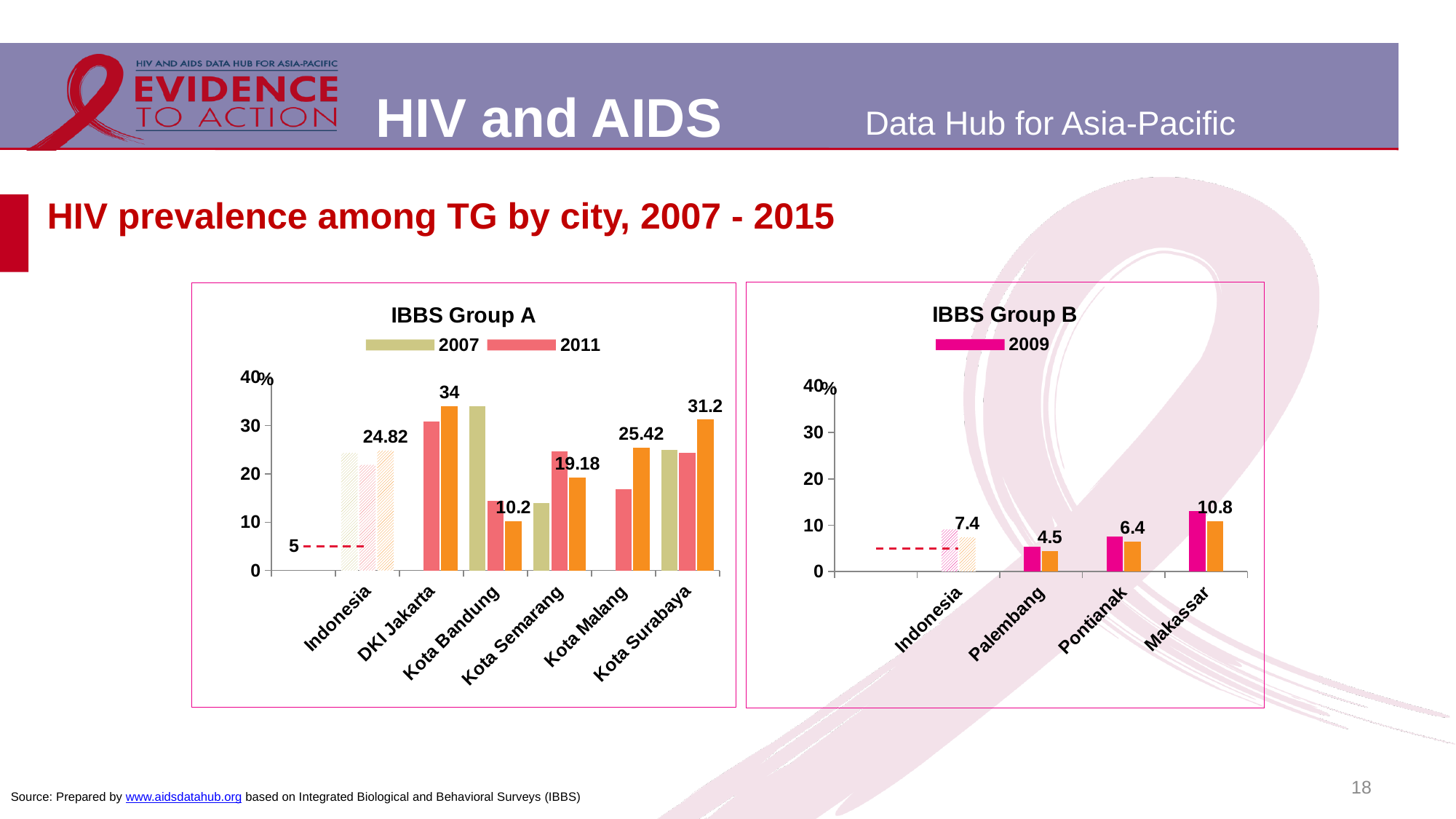
In the IBBS Group B chart, which category has the highest labelled value? Makassar How many categories are shown on the x axis of the IBBS Group A chart? 6 In the IBBS Group B chart, is the 2009 value for Makassar greater or less than 10? greater In the IBBS Group A chart, what value is labelled for Kota Surabaya? 31.2 In the IBBS Group A chart, which city has the lowest labelled value? Kota Bandung In the IBBS Group A chart, which labelled value is larger: Kota Malang or Kota Semarang? Kota Malang In the IBBS Group B chart, what value is labelled for Pontianak? 6.4 What kind of chart is the IBBS Group B chart? bar chart In the IBBS Group A chart, is the 2007 value for Kota Bandung greater or less than 30? greater In the IBBS Group A chart, what value is labelled for DKI Jakarta? 34 In the IBBS Group B chart, what is the difference between the labelled values for Makassar and Palembang? 6.3 In the IBBS Group A chart, what value is labelled for Kota Semarang? 19.18